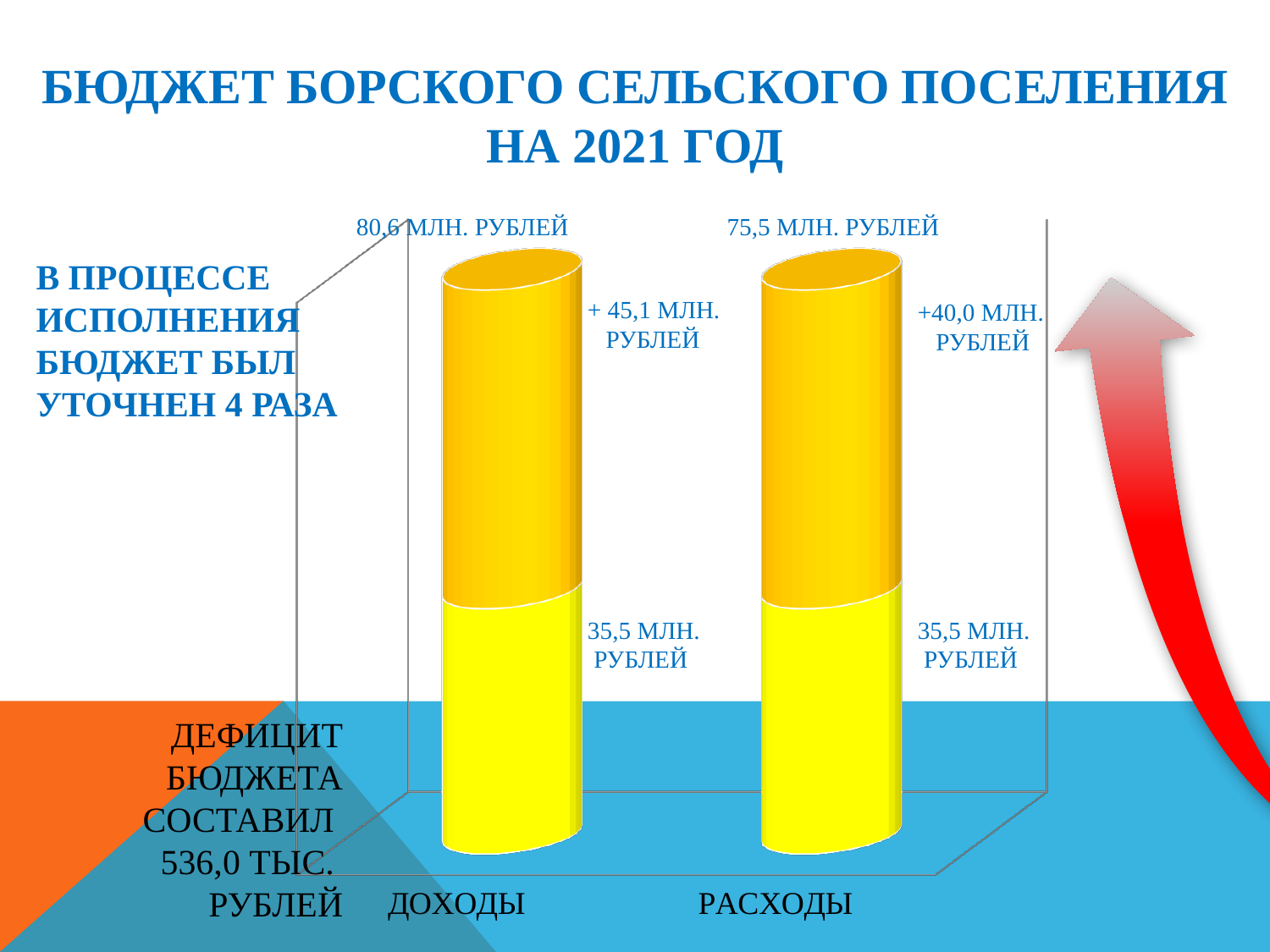
What is the title of the slide containing the chart? БЮДЖЕТ БОРСКОГО СЕЛЬСКОГО ПОСЕЛЕНИЯ НА 2021 ГОД What value is labelled on the lower (yellow) segment of the РАСХОДЫ bar? 35,5 МЛН. РУБЛЕЙ Which category has the higher total, ДОХОДЫ or РАСХОДЫ? ДОХОДЫ What value is labelled on the upper (orange) segment of the РАСХОДЫ bar? +40,0 МЛН. РУБЛЕЙ What is the total value shown above the РАСХОДЫ bar? 75,5 МЛН. РУБЛЕЙ What kind of chart is shown on the slide? Bar chart What value is labelled on the upper (orange) segment of the ДОХОДЫ bar? + 45,1 МЛН. РУБЛЕЙ What is the difference between the upper segments of ДОХОДЫ (+45,1) and РАСХОДЫ (+40,0), in млн. рублей? 5,1 What value is labelled on the lower (yellow) segment of the ДОХОДЫ bar? 35,5 МЛН. РУБЛЕЙ What is the difference between the totals of ДОХОДЫ and РАСХОДЫ, in млн. рублей? 5,1 How many categories are shown on the x axis of the chart? 2 What is the total value shown above the ДОХОДЫ bar? 80,6 МЛН. РУБЛЕЙ